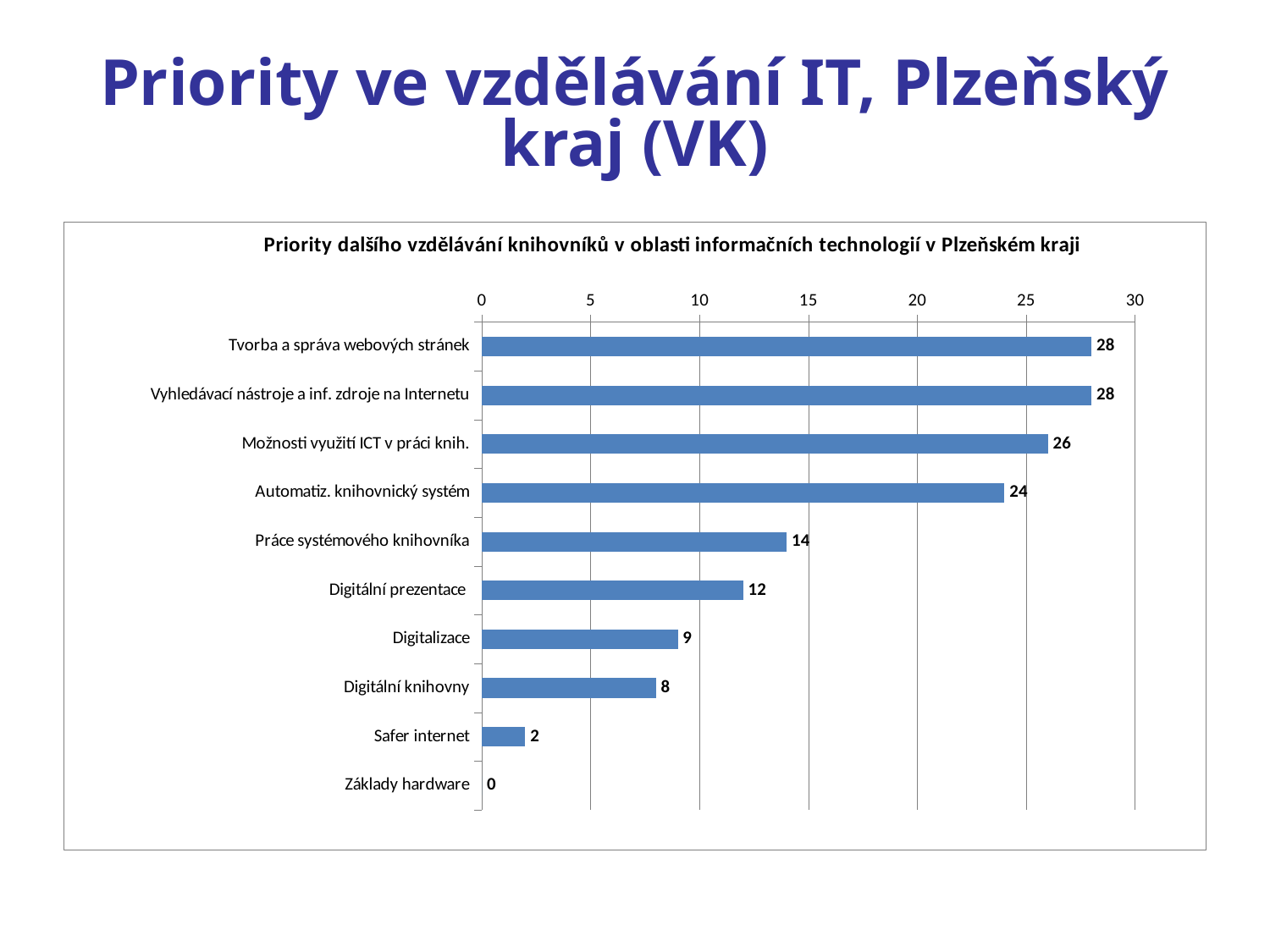
What is the title of the chart? Priority dalšího vzdělávání knihovníků v oblasti informačních technologií v Plzeňském kraji What is the value for Safer internet? 2 What is the value for Digitální prezentace? 12 What is the value for Automatiz. knihovnický systém? 24 What is the difference between the values for Tvorba a správa webových stránek and Automatiz. knihovnický systém? 4 Which is larger, the value for Digitalizace or the value for Digitální knihovny? Digitalizace What is the value for Možnosti využití ICT v práci knih.? 26 What is the difference between the values for Práce systémového knihovníka and Digitalizace? 5 Is the value for Práce systémového knihovníka greater or less than 10? greater Which category has the lowest value? Základy hardware How many categories are shown in the chart? 10 What kind of chart is shown on the slide? bar chart